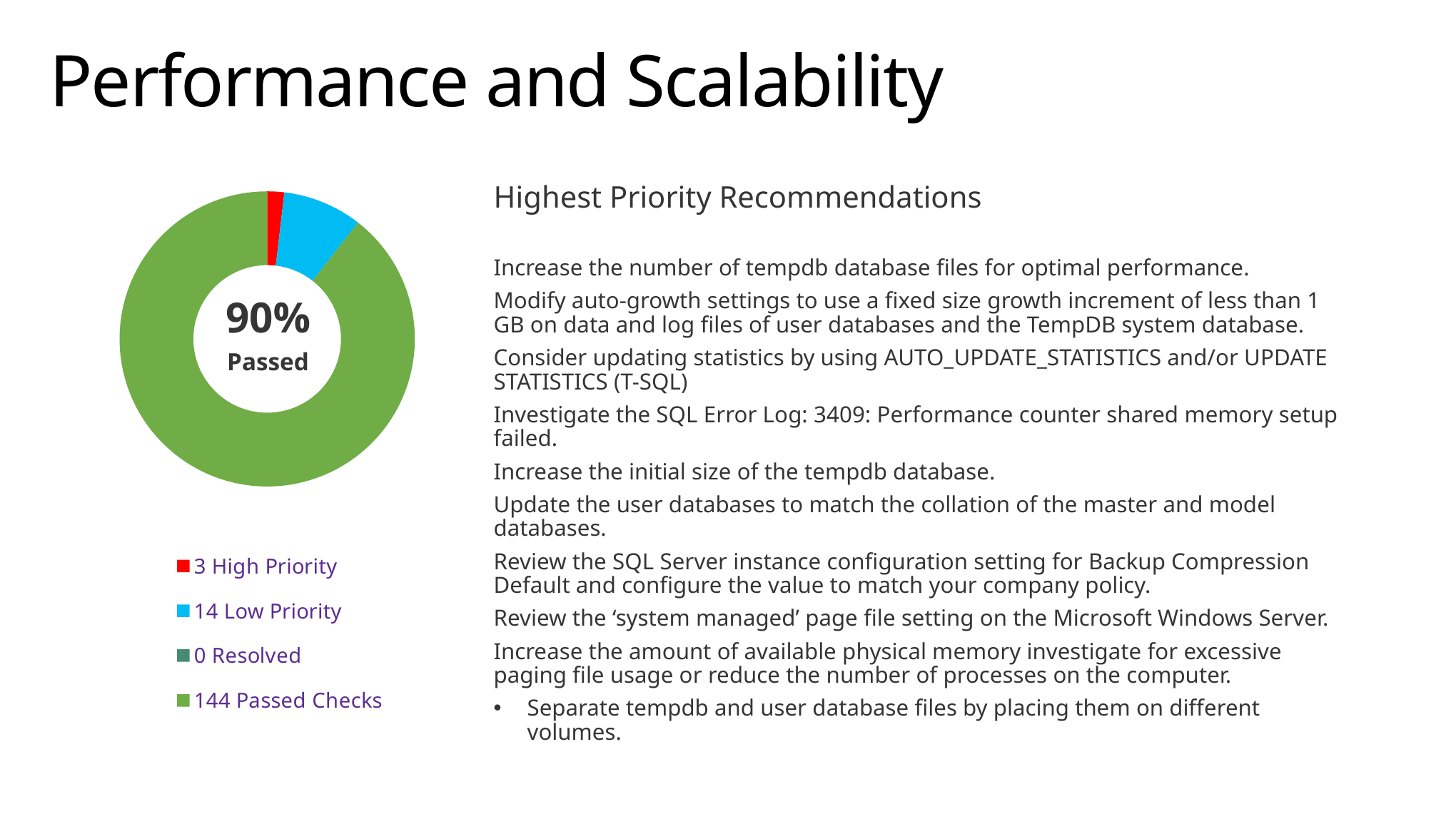
Which category has the smallest value in the chart? Resolved Which is larger, the number of Low Priority items or the number of High Priority items? Low Priority What percentage is shown in the centre of the donut chart as Passed? 90% What is the difference between the number of Low Priority items and High Priority items? 11 How many Passed Checks does the legend show? 144 What kind of chart is shown on the slide? Donut chart How many Resolved items does the legend show? 0 How many categories does the legend list? 4 Which category has the largest value in the chart? Passed Checks What colour represents High Priority in the chart? Red How many Low Priority items does the legend show? 14 How many High Priority items does the legend show? 3